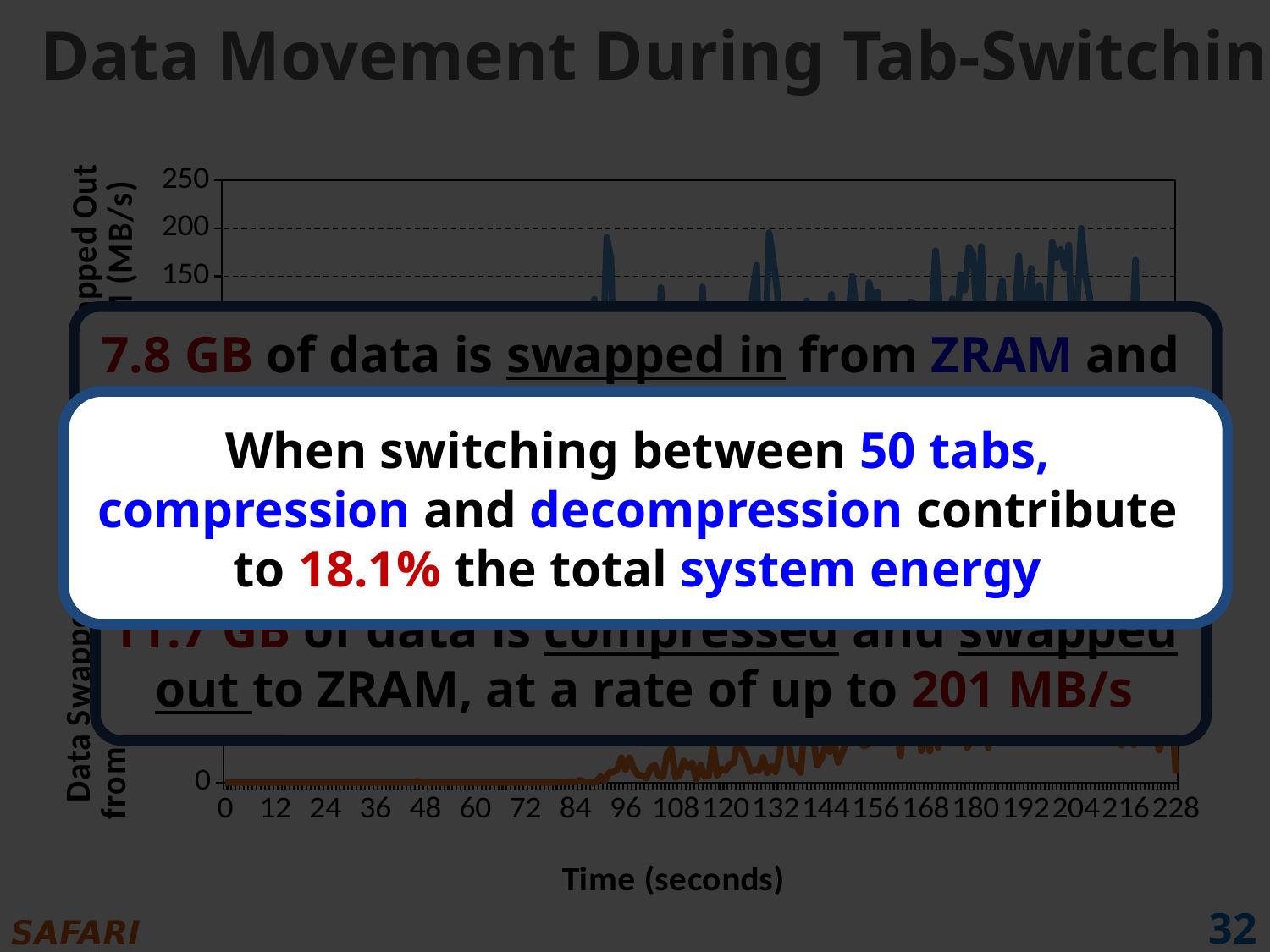
Does the orange line in the bottom chart rise or stay flat after about 84 seconds? rise Is the peak value of the blue line in the top chart greater or less than 250? less What kind of chart is shown on the slide? line chart Between 0 and 84 seconds, is the value of the blue line in the top chart greater or less than 150? less What is the largest tick label on the x axis? 228 How many tick labels are shown on the x axis (from 0 to 228 in steps of 12)? 20 What colour is the line plotted in the top chart (Data Swapped Out)? blue What is the highest tick label on the y axis of the top chart? 250 What is the title of the x axis of the chart? Time (seconds) Is the peak value of the blue line in the top chart greater or less than 150? greater